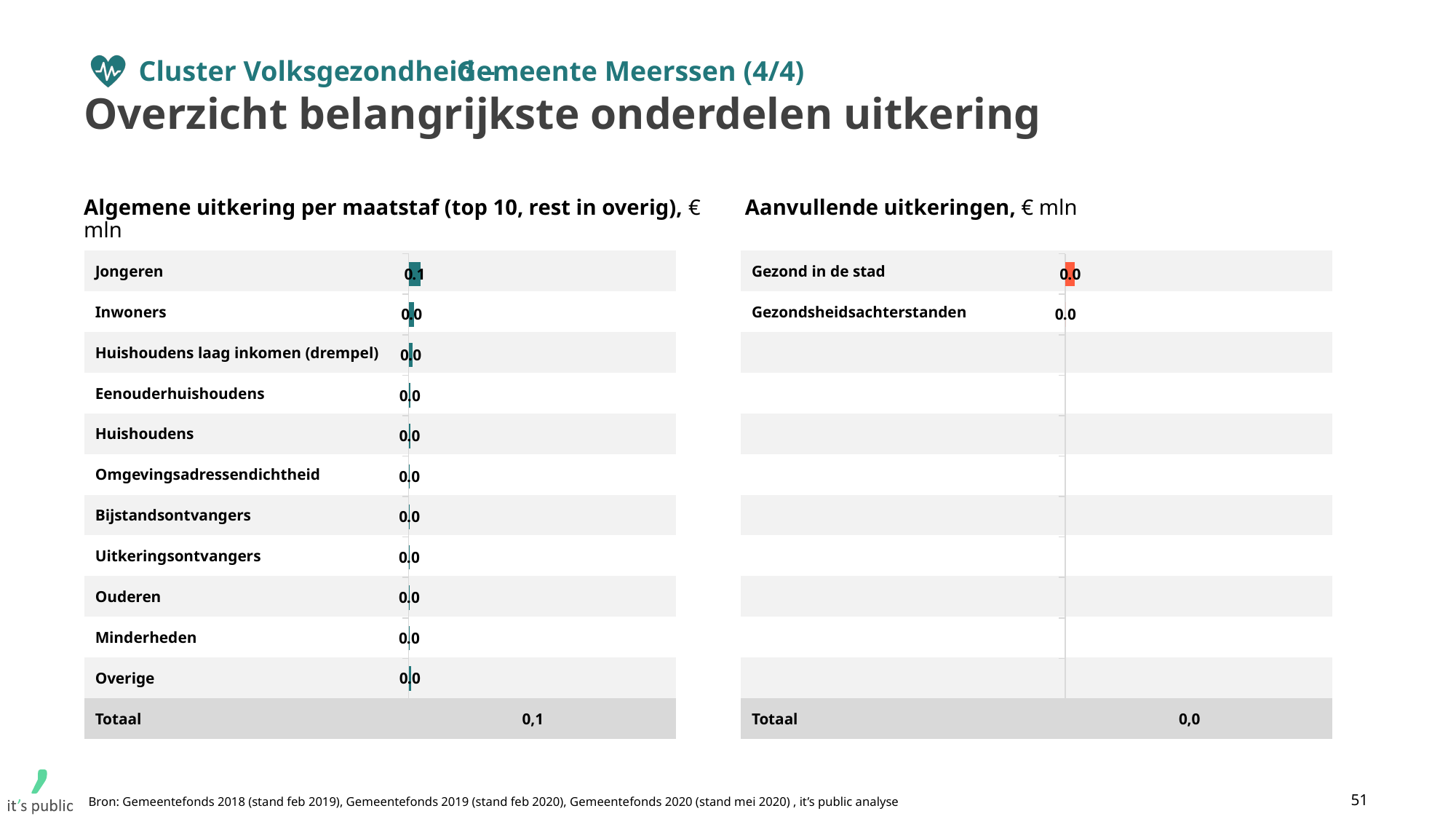
In the left chart (Algemene uitkering per maatstaf), what is the difference between the values for Jongeren and Ouderen? 0.1 What unit is stated in the title of the right chart (Aanvullende uitkeringen)? € mln In the right chart (Aanvullende uitkeringen), what is the value for Gezond in de stad? 0.0 In the left chart (Algemene uitkering per maatstaf), which category has the highest value? Jongeren In the right chart (Aanvullende uitkeringen), what is the Totaal value shown? 0,0 In the right chart (Aanvullende uitkeringen), how many categories are listed, excluding the Totaal row? 2 In the left chart (Algemene uitkering per maatstaf), what is the Totaal value shown? 0,1 In the left chart (Algemene uitkering per maatstaf), what is the value for Inwoners? 0.0 In the left chart (Algemene uitkering per maatstaf), which is larger: the value for Jongeren or the value for Minderheden? Jongeren In the left chart (Algemene uitkering per maatstaf), how many categories are listed, excluding the Totaal row? 11 In the left chart (Algemene uitkering per maatstaf), what is the value for Jongeren? 0.1 What kind of chart is the left chart (Algemene uitkering per maatstaf)? Bar chart